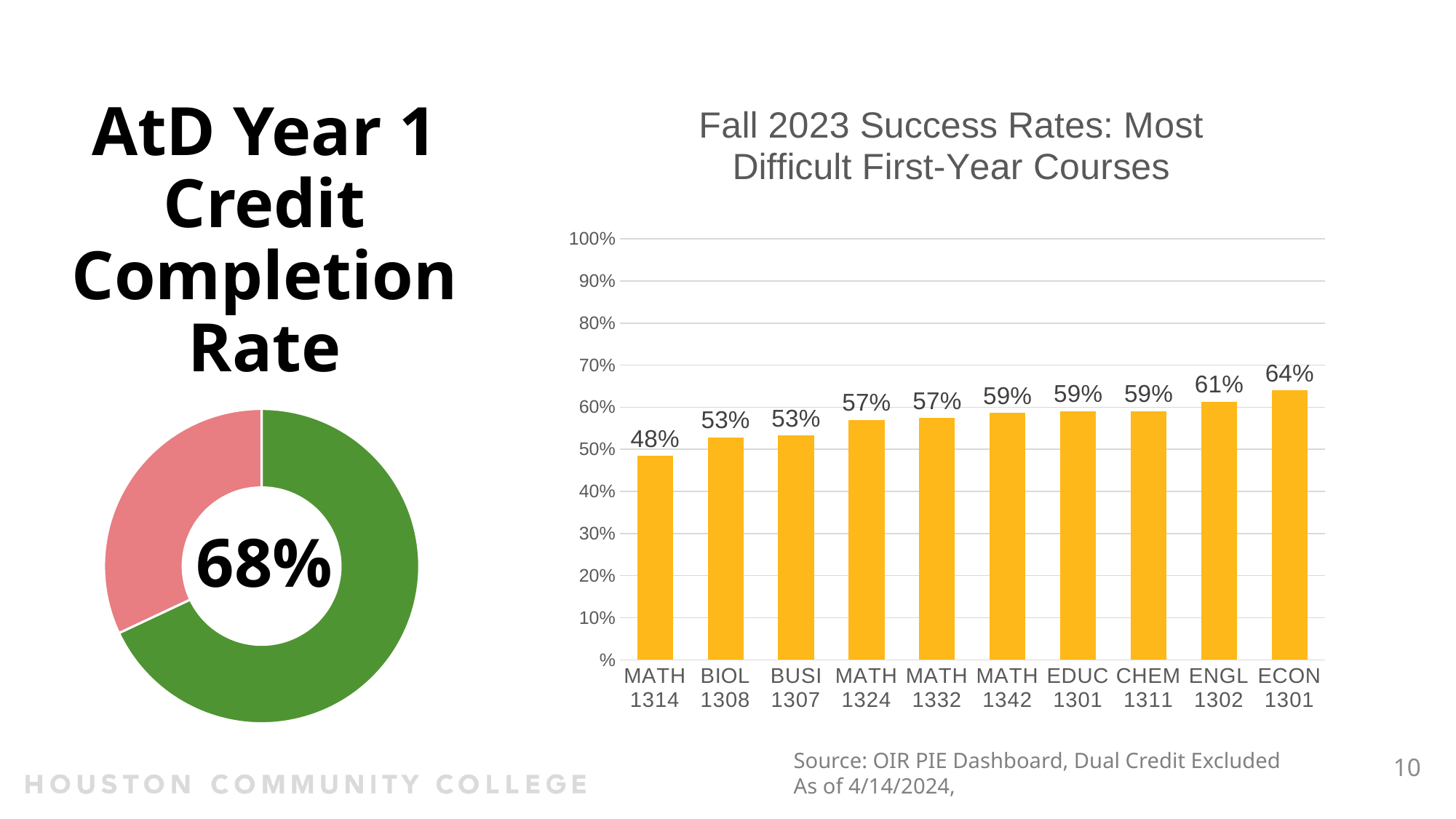
In the 'Fall 2023 Success Rates: Most Difficult First-Year Courses' chart, what is the success rate for MATH 1314? 48% In the 'Fall 2023 Success Rates: Most Difficult First-Year Courses' chart, do the success rates rise or fall from left to right? Rise In the 'Fall 2023 Success Rates: Most Difficult First-Year Courses' chart, which course has the lowest success rate? MATH 1314 What kind of chart is the 'AtD Year 1 Credit Completion Rate' chart on the left of the slide? Donut chart In the 'Fall 2023 Success Rates: Most Difficult First-Year Courses' chart, which course has the highest success rate? ECON 1301 In the 'Fall 2023 Success Rates: Most Difficult First-Year Courses' chart, which has a higher success rate, BIOL 1308 or MATH 1324? MATH 1324 What value is shown in the centre of the 'AtD Year 1 Credit Completion Rate' donut chart on the left? 68% What kind of chart is the 'Fall 2023 Success Rates: Most Difficult First-Year Courses' chart? Bar chart In the 'Fall 2023 Success Rates: Most Difficult First-Year Courses' chart, what is the success rate for CHEM 1311? 59% In the 'Fall 2023 Success Rates: Most Difficult First-Year Courses' chart, how many courses are shown? 10 In the 'Fall 2023 Success Rates: Most Difficult First-Year Courses' chart, what is the success rate for ENGL 1302? 61% In the 'Fall 2023 Success Rates: Most Difficult First-Year Courses' chart, what is the difference between the success rates of ECON 1301 and MATH 1314? 16%